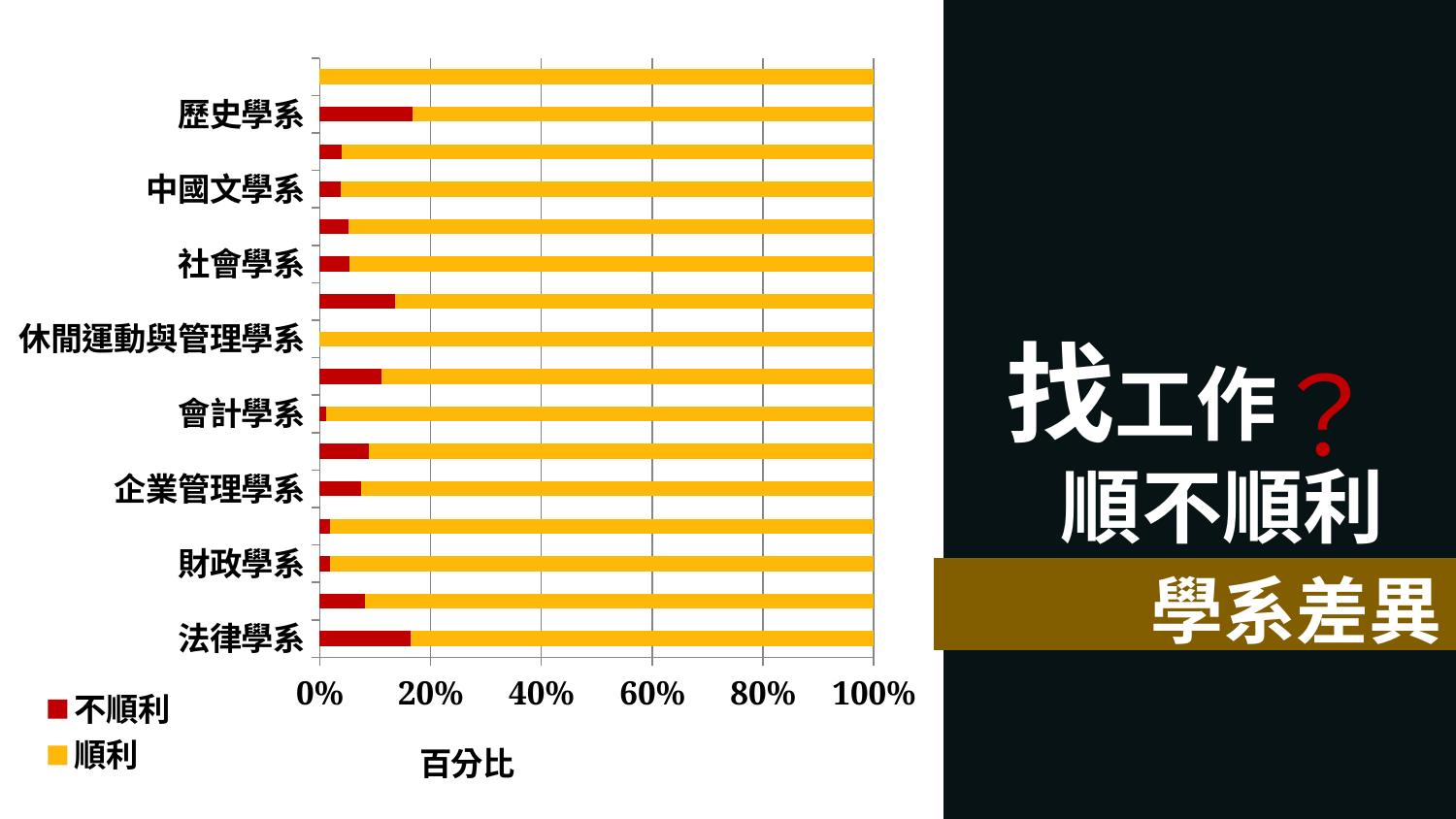
What is the title of the horizontal axis of the chart? 百分比 Is the 順利 value for 法律學系 greater or less than 80%? greater How many series does the chart legend list? 2 Is the 不順利 value for 法律學系 greater or less than 20%? less What type of chart is shown on the slide? bar chart Which has a larger 順利 share, 會計學系 or 法律學系? 會計學系 What are the two series named in the chart legend? 不順利 and 順利 Which has a larger 不順利 share, 法律學系 or 會計學系? 法律學系 Which has a larger 不順利 share, 歷史學系 or 財政學系? 歷史學系 Is the 不順利 value for 歷史學系 greater or less than 20%? less How many department labels are shown on the vertical axis of the chart? 8